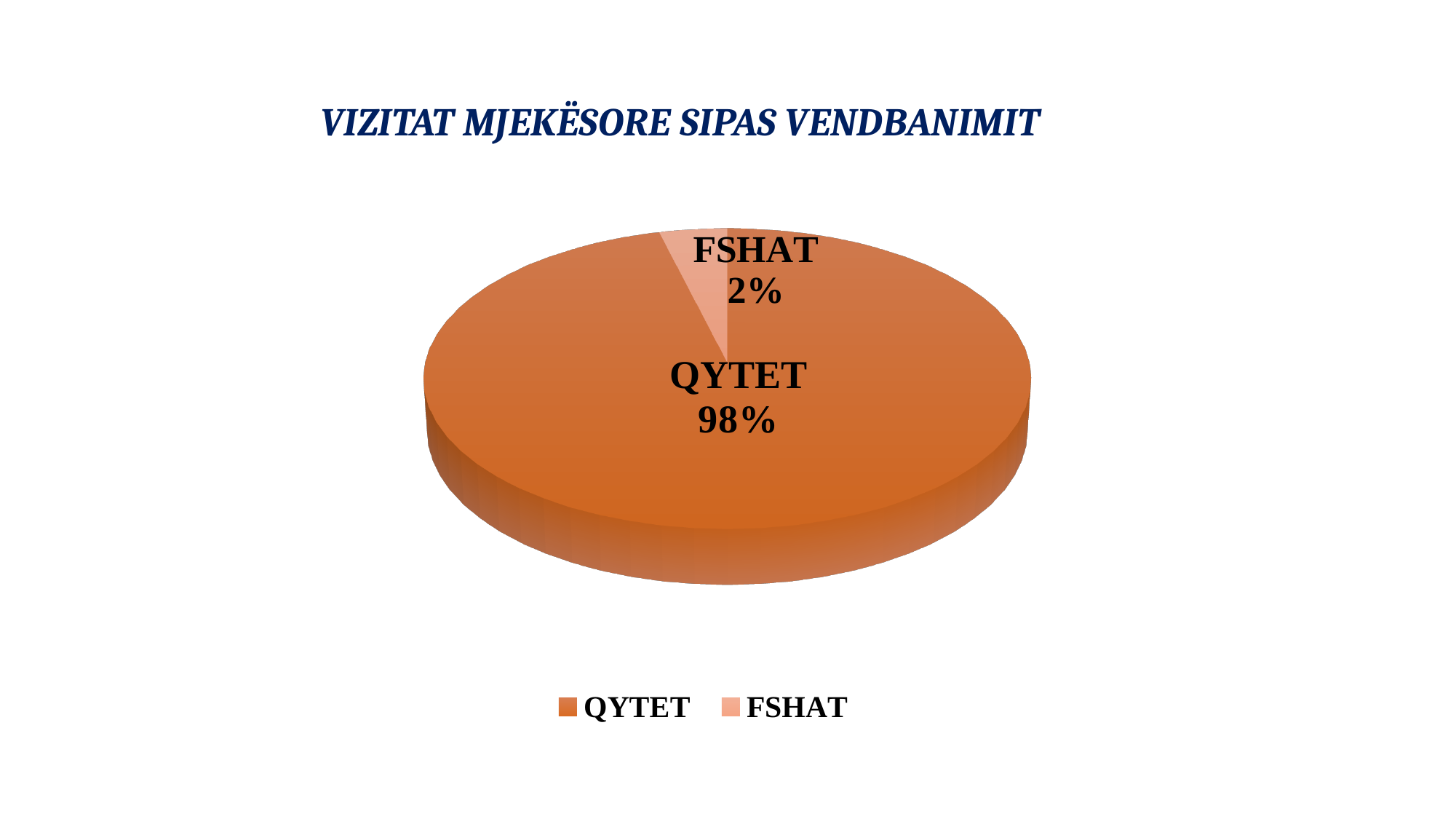
What is the difference in percentage points between the QYTET and FSHAT slices? 96 What type of chart is shown on the slide? pie chart Which slice is larger, QYTET or FSHAT? QYTET What percentage of the pie is labelled QYTET? 98% How many entries does the legend list? 2 What share of the pie does the FSHAT slice represent? 2% What is the title of the chart? VIZITAT MJEKËSORE SIPAS VENDBANIMIT Which category has the smallest share of the pie? FSHAT Which category has the largest share of the pie? QYTET How many slices does the pie chart have? 2 What percentage of the pie is labelled FSHAT? 2% Which legend entry is shown in the lighter orange colour? FSHAT